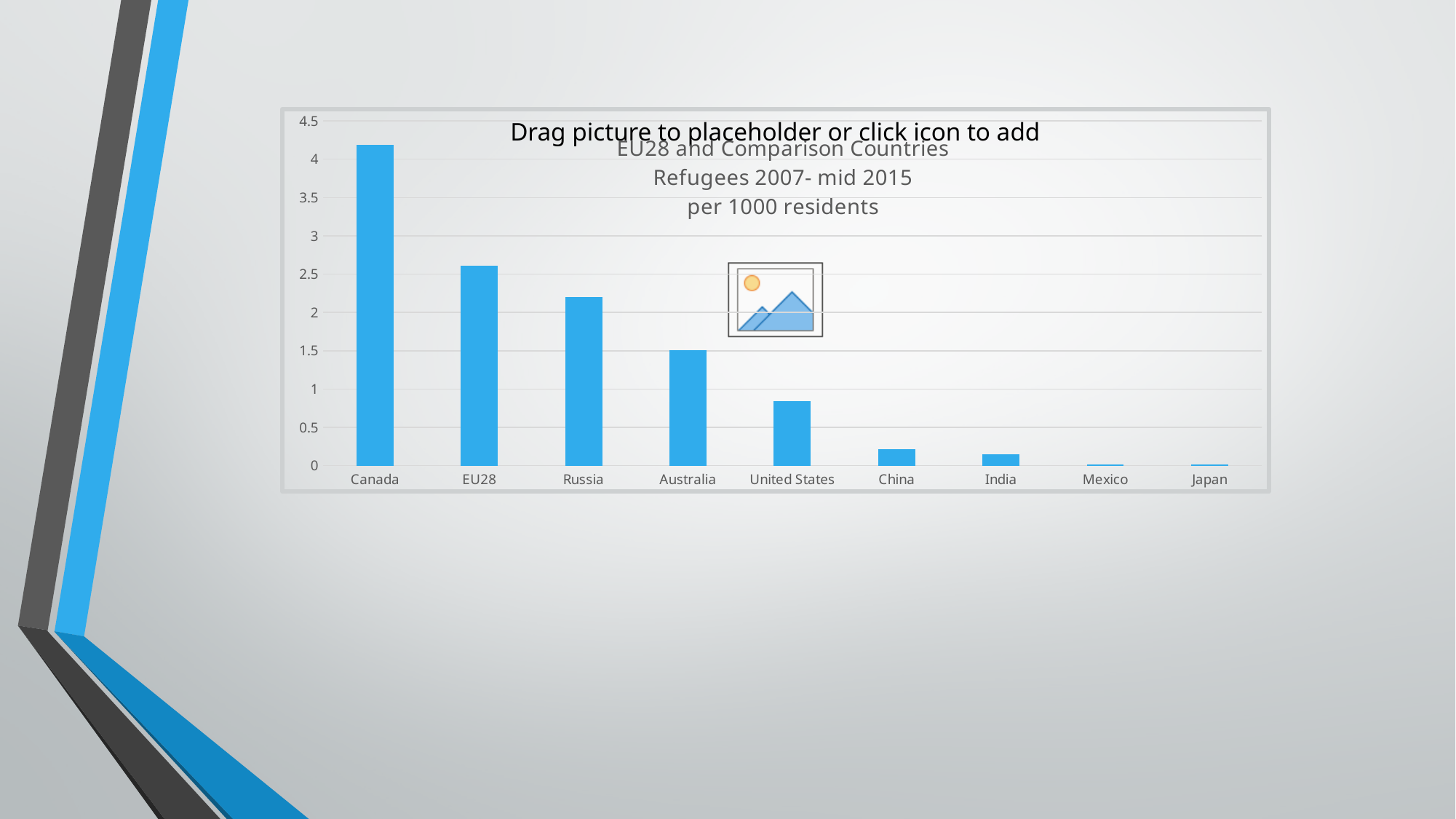
Which has a larger value, Canada or EU28? Canada Do the bar values rise or fall moving from left to right along the x axis? fall Is the value for Russia greater or less than 2? greater What kind of chart is shown on the slide? bar chart Which category has the highest value in the chart? Canada What unit does the chart title say the refugee figures are expressed in? per 1000 residents How many countries/regions are shown on the x axis of the chart? 9 Is the value for China greater or less than 0.5? less Is the value for United States greater or less than 1? less Which has a larger value, Australia or United States? Australia